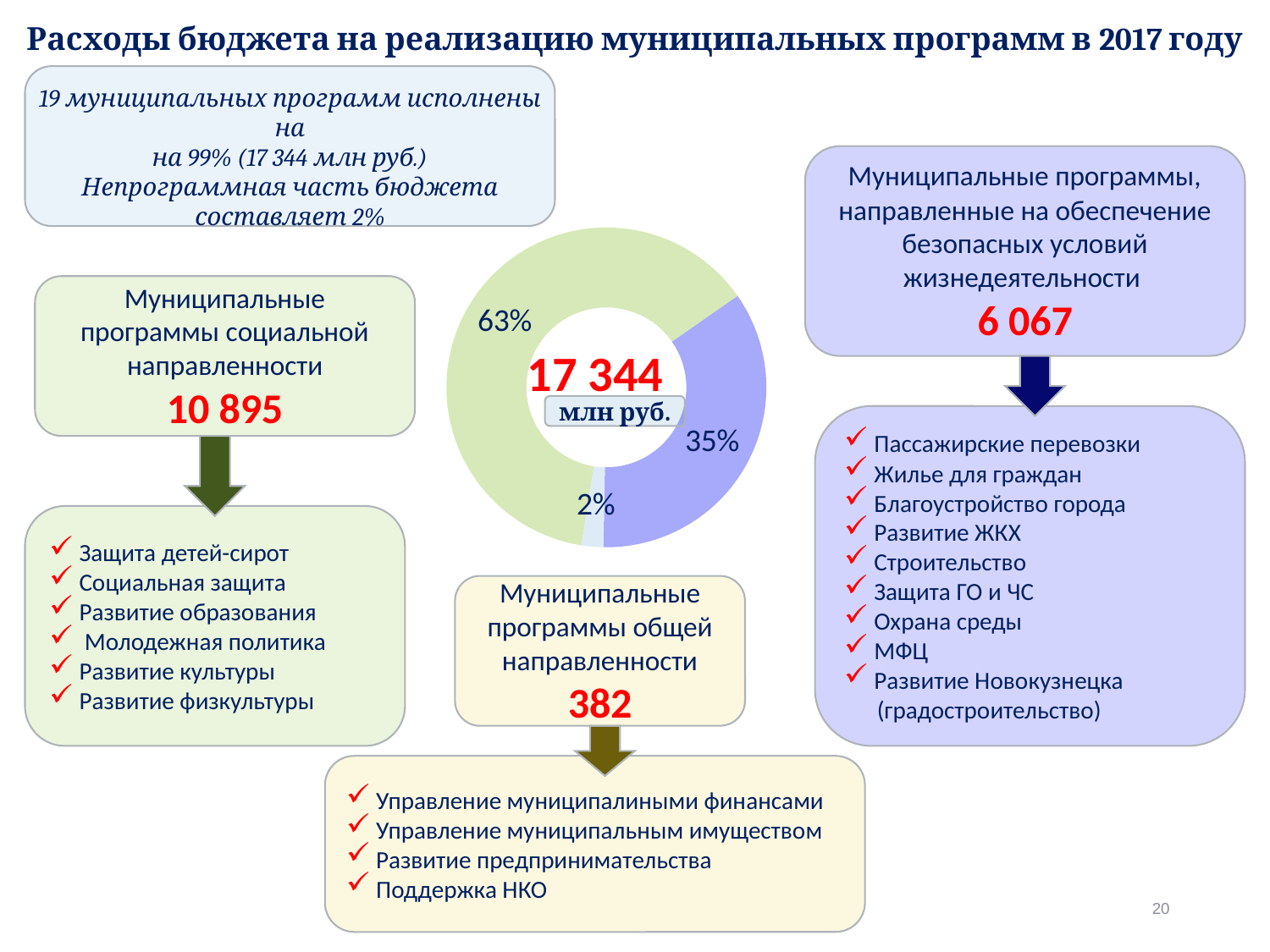
By how many percentage points does the 63% slice exceed the 35% slice? 28 What percentage is shown for the blue (purple) slice of the pie chart? 35% How many slices does the pie chart have? 3 What percentage is shown for the green slice of the pie chart? 63% What share of the pie does the green slice represent? 63% By how many percentage points does the 35% slice exceed the 2% slice? 33 What total value is printed in the centre of the pie chart? 17 344 млн руб. What is the smallest share shown on the pie chart? 2% What kind of chart is shown in the centre of the slide? pie chart (donut) What is the largest share shown on the pie chart? 63% What percentage is shown for the light blue slice of the pie chart? 2% Which slice is larger on the pie chart, the green one or the blue one? the green one (63%)